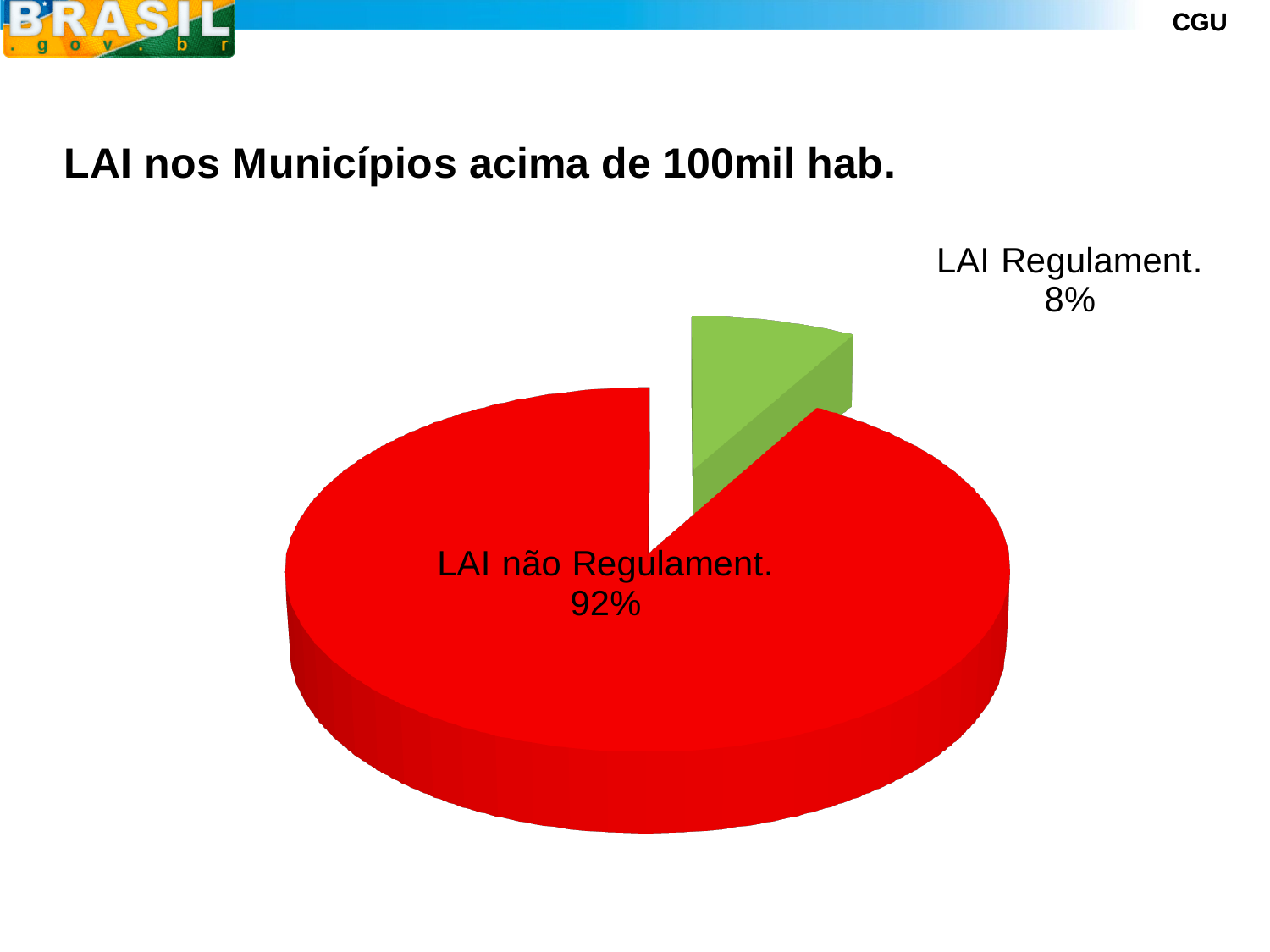
What is the title of the chart? LAI nos Municípios acima de 100mil hab. What share of the pie does "LAI Regulament." represent? 8% Which slice is the largest? LAI não Regulament. What kind of chart is shown on the slide? pie chart Which is larger, "LAI Regulament." or "LAI não Regulament."? LAI não Regulament. How many slices does the pie chart have? 2 What share of the pie does "LAI não Regulament." represent? 92% Which slice is the smallest? LAI Regulament. What colour is the "LAI Regulament." slice? green What is the difference in percentage points between "LAI não Regulament." and "LAI Regulament."? 84